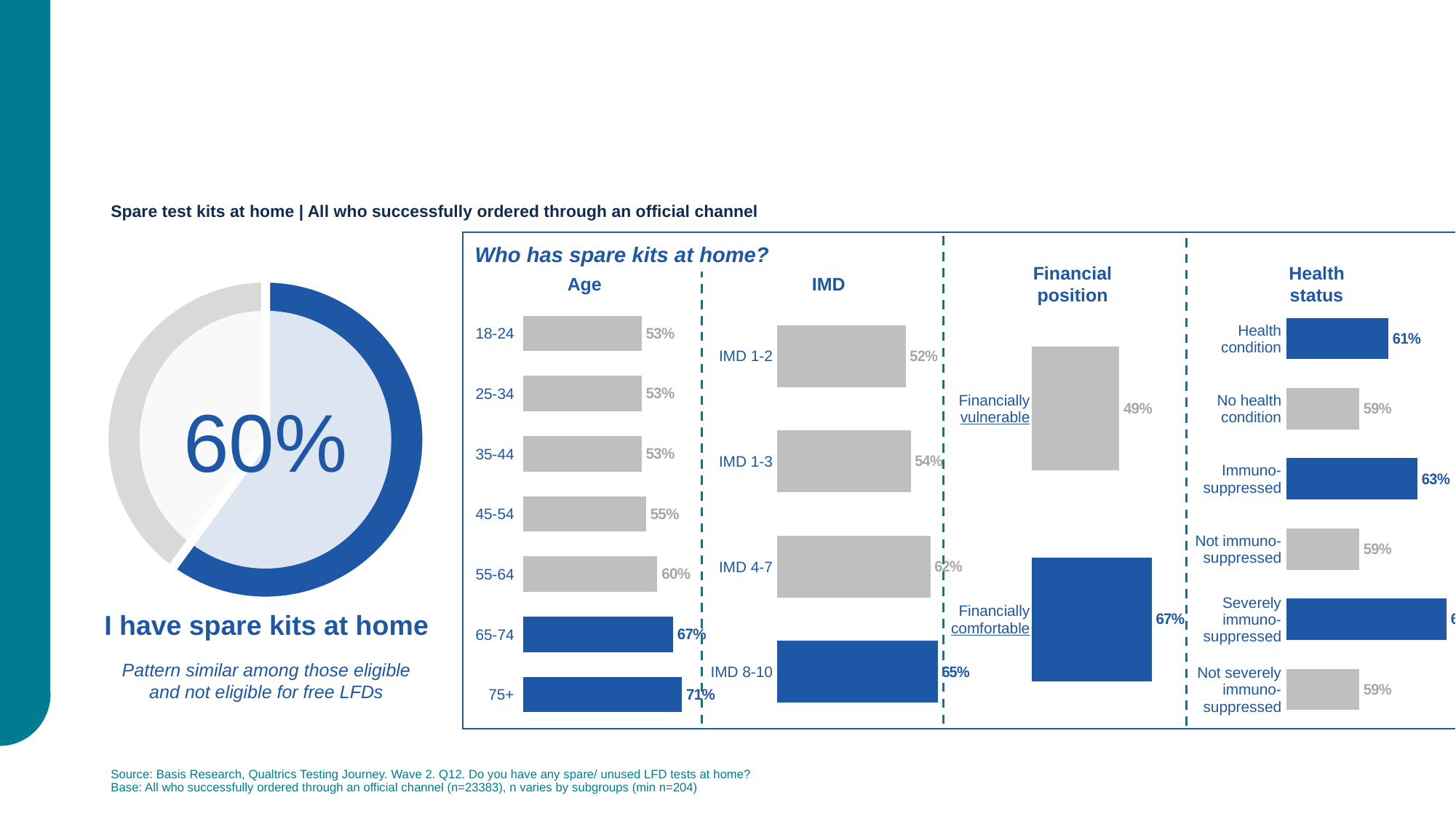
In the Health status chart, what is the value for Health condition? 61% In the IMD chart, what is the value for IMD 8-10? 65% In the IMD chart, which category has the lowest value? IMD 1-2 In the Financial position chart, what is the value for Financially vulnerable? 49% In the Health status chart, which is larger: Immuno-suppressed or Not immuno-suppressed? Immuno-suppressed In the Age chart, how many age groups are shown? 7 In the Age chart, which age group has the highest value? 75+ In the Age chart, what is the difference between the values for 75+ and 55-64? 11 percentage points In the Financial position chart, what is the difference between Financially comfortable and Financially vulnerable? 18 percentage points What percentage does the donut chart on the left show for 'I have spare kits at home'? 60% In the IMD chart, do the values rise or fall from IMD 1-2 to IMD 8-10? rise In the Age chart, what percentage of those aged 75+ have spare kits at home? 71%